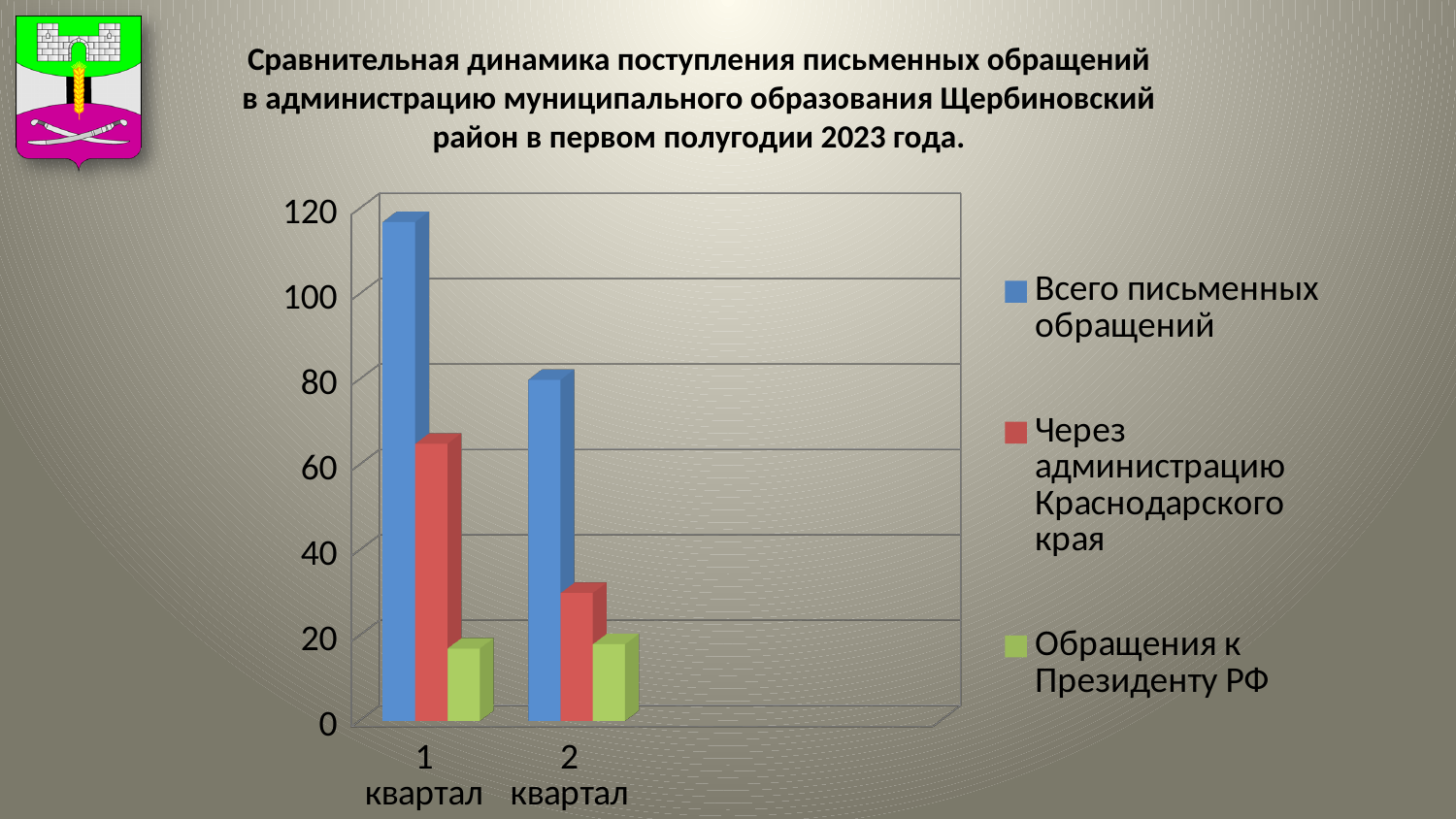
Which colour represents "Обращения к Президенту РФ" in the legend? green Does the value for "Всего письменных обращений" rise or fall from 1 квартал to 2 квартал? fall How many series does the legend list? 3 Is the value for "Через администрацию Краснодарского края" in 1 квартал greater or less than 60? greater How many categories (quarters) are shown on the x axis? 2 Is the value for "Всего письменных обращений" in 1 квартал greater or less than 100? greater Is the value for "Всего письменных обращений" in 2 квартал greater or less than 100? less What kind of chart is shown on the slide? bar chart In which quarter is the value for "Через администрацию Краснодарского края" lower? 2 квартал Which is larger in 2 квартал: "Через администрацию Краснодарского края" or "Обращения к Президенту РФ"? Через администрацию Краснодарского края In which quarter is the value for "Всего письменных обращений" higher? 1 квартал